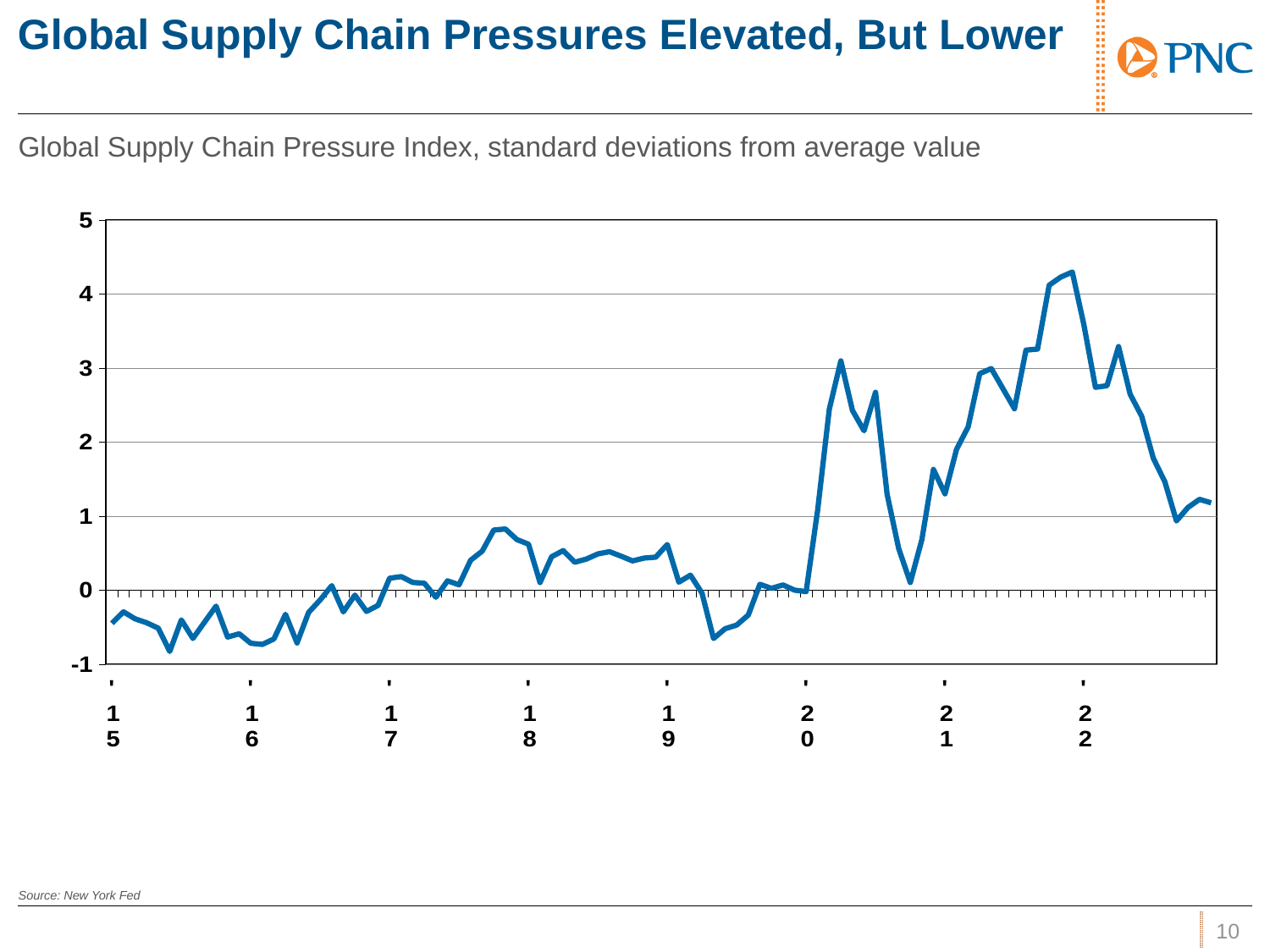
What source is cited for the chart? New York Fed Is the value of the index at the start of 2021 greater or less than 1? greater What is the highest value shown on the y axis? 5 Is the value of the index at the start of 2020 greater or less than 1? less How many year labels are shown on the x axis? 8 Does the index rise or fall from its peak near the end of 2021 to the end of 2022? fall Is the value of the index at the start of 2015 greater or less than 0? less Which is larger, the index value at the start of 2018 or the index value at the start of 2022? start of 2022 What kind of chart is shown on the slide? line chart What is the subtitle describing the data plotted in the chart? Global Supply Chain Pressure Index, standard deviations from average value